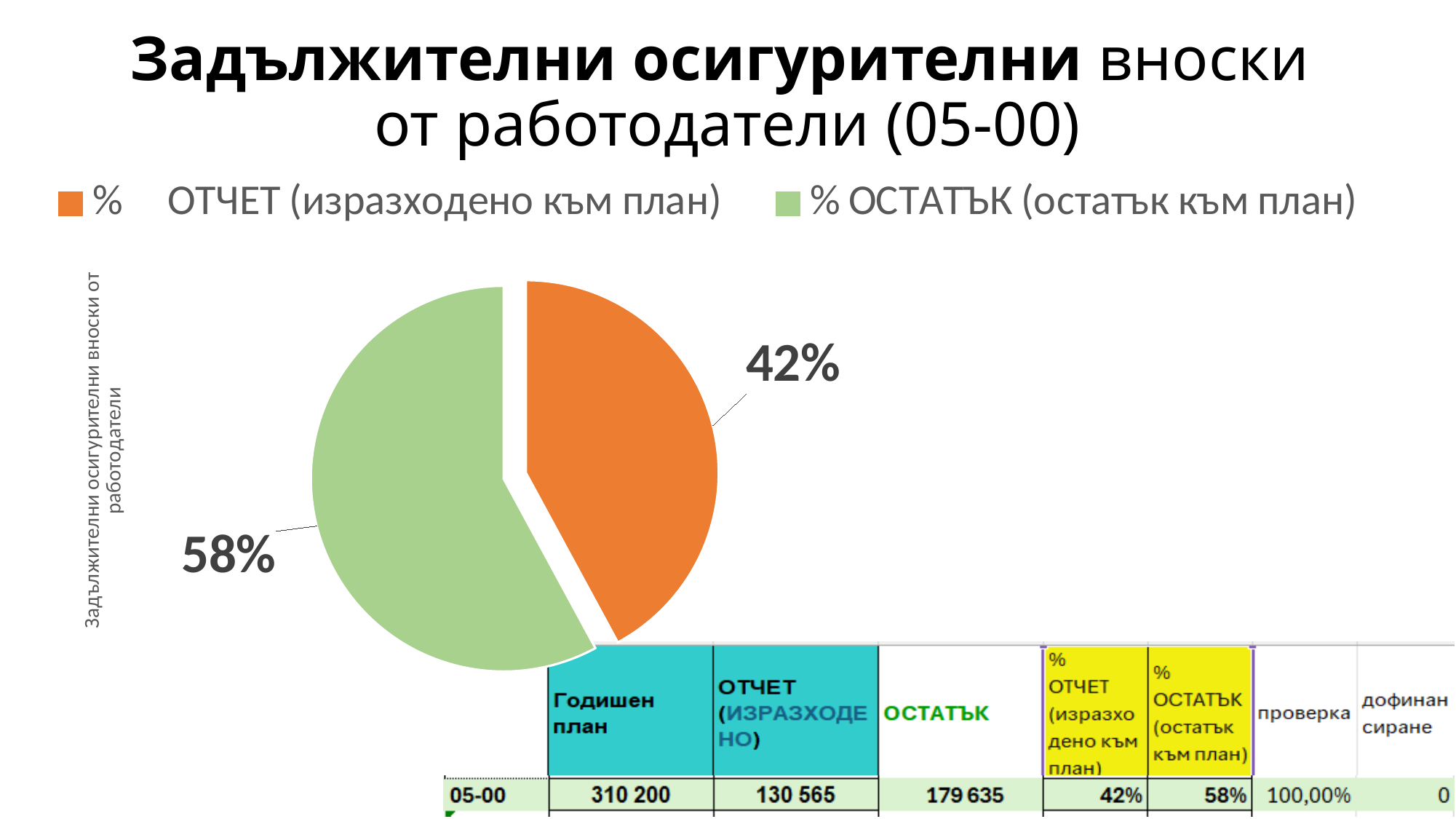
What share of the pie does the "% ОТЧЕТ (изразходено към план)" slice represent? 42% How many entries does the legend list? 2 What is the difference in percentage points between the "% ОСТАТЪК" slice and the "% ОТЧЕТ" slice? 16 What colour is the "% ОТЧЕТ (изразходено към план)" slice? orange What share of the pie does the "% ОСТАТЪК (остатък към план)" slice represent? 58% What colour is the "% ОСТАТЪК (остатък към план)" slice? green Is the share of the "% ОТЧЕТ" slice greater or less than 50%? less How many slices does the pie chart have? 2 Which is larger: the "% ОТЧЕТ" slice or the "% ОСТАТЪК" slice? % ОСТАТЪК What kind of chart is shown on the slide? pie chart Which slice of the pie is the largest? % ОСТАТЪК (остатък към план) Which slice of the pie is the smallest? % ОТЧЕТ (изразходено към план)